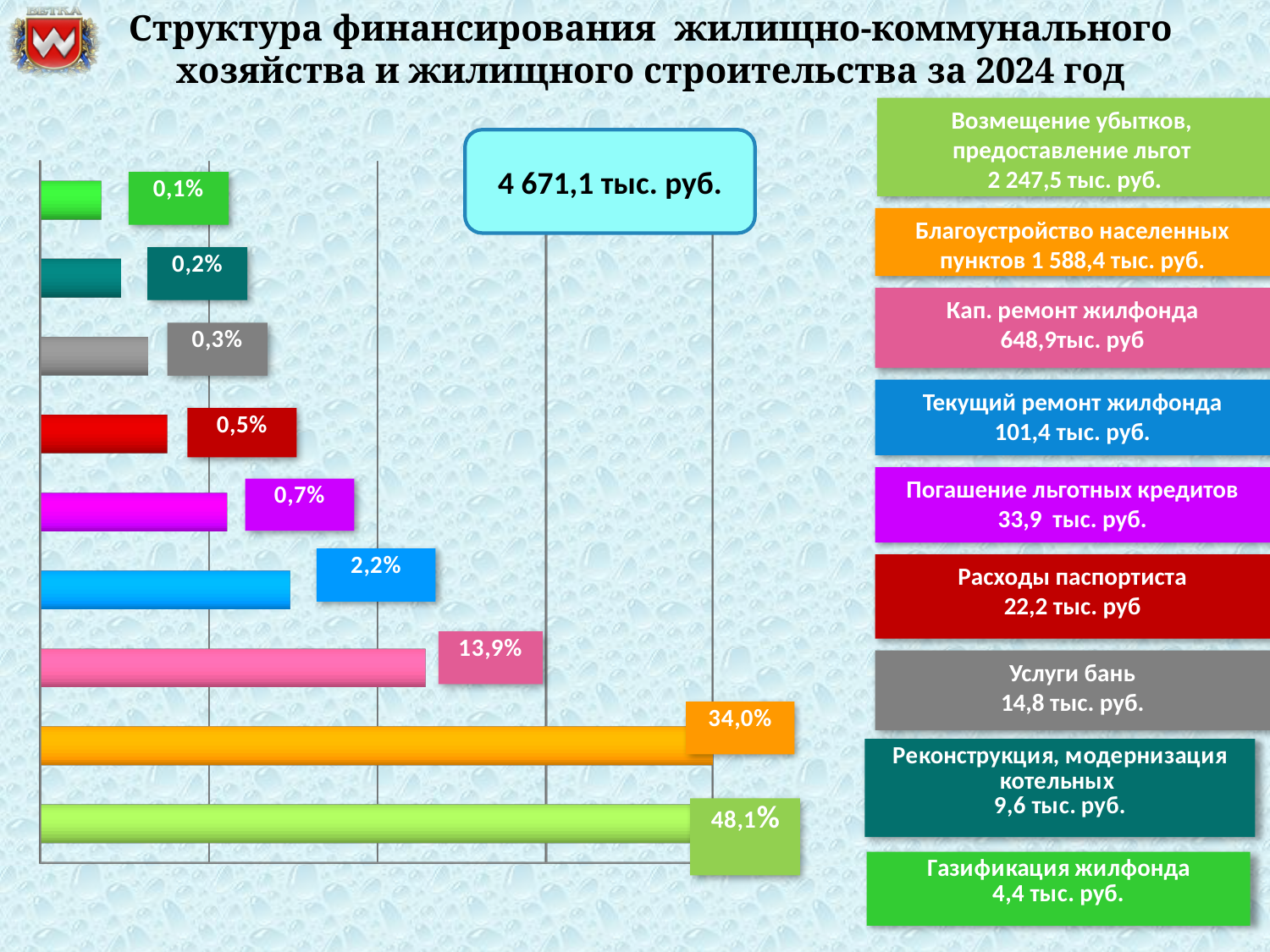
What kind of chart is shown on the slide? bar chart What is the smallest percentage shown on any bar in the chart? 0,1% What is the largest percentage shown on any bar in the chart? 48,1% What percentage is labelled on the blue bar (Текущий ремонт жилфонда)? 2,2% What year does the chart title say the financing structure refers to? 2024 What percentage is labelled on the pink bar (Кап. ремонт жилфонда)? 13,9% What total amount is shown in the box above the chart? 4 671,1 тыс. руб. Which bar is longer: the magenta bar (0,7%) or the red bar (0,5%)? the magenta bar (0,7%) What is the difference in percentage points between the longest bar (48,1%) and the second longest bar (34,0%)? 14,1 According to the legend, what amount corresponds to Услуги бань? 14,8 тыс. руб. How many bars are plotted in the chart? 9 What percentage is labelled on the orange bar (Благоустройство населенных пунктов)? 34,0%